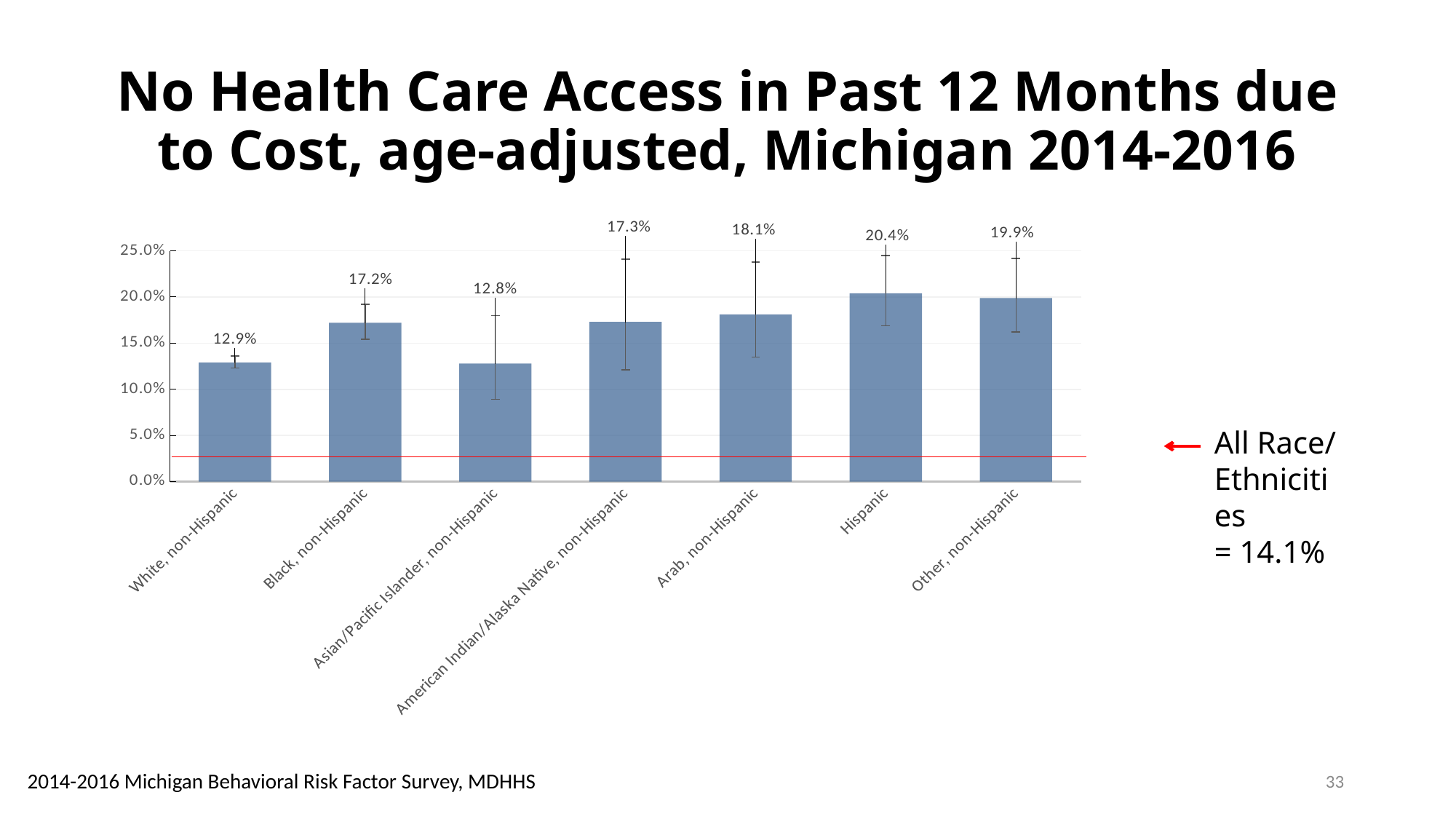
What is the value for White, non-Hispanic? 12.9% What is the difference between the values for Other, non-Hispanic and Black, non-Hispanic? 2.7% What kind of chart is this? bar chart Which category has the highest value? Hispanic What is the value for Hispanic? 20.4% What is the value for Arab, non-Hispanic? 18.1% Which category has the lowest value? Asian/Pacific Islander, non-Hispanic Which is larger, the value for Arab, non-Hispanic or the value for Black, non-Hispanic? Arab, non-Hispanic What is the difference between the values for Hispanic and White, non-Hispanic? 7.5% How many categories are shown on the x axis? 7 What is the value for Asian/Pacific Islander, non-Hispanic? 12.8% What value is given for All Race/Ethnicities in the annotation next to the chart? 14.1%